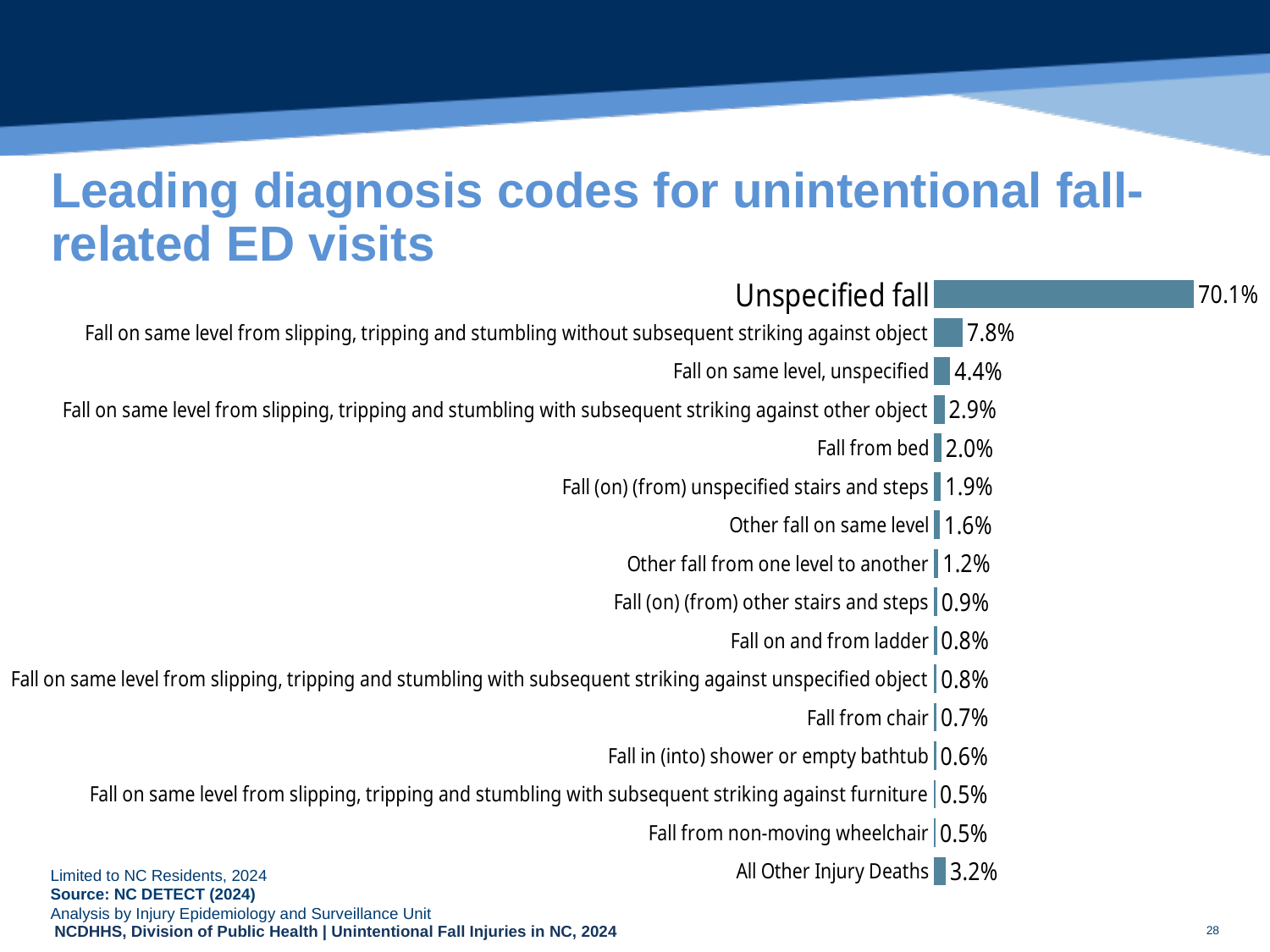
What is the difference between the values for Unspecified fall and Fall on same level, unspecified? 65.7% What is the title of the slide? Leading diagnosis codes for unintentional fall-related ED visits What kind of chart is shown on the slide? Bar chart Which is larger, the value for All Other Injury Deaths or the value for Fall on same level from slipping, tripping and stumbling with subsequent striking against other object? All Other Injury Deaths Which diagnosis code has the highest percentage? Unspecified fall What is the value shown for Fall on and from ladder? 0.8% How many diagnosis code categories are plotted in the chart? 16 What is the value shown for All Other Injury Deaths? 3.2% Which is larger, the value for Other fall on same level or the value for Fall (on) (from) other stairs and steps? Other fall on same level What is the difference between the values for Fall from bed and Fall from chair? 1.3% What percentage of unintentional fall-related ED visits is attributed to Unspecified fall? 70.1% What is the value shown for Fall from bed? 2.0%